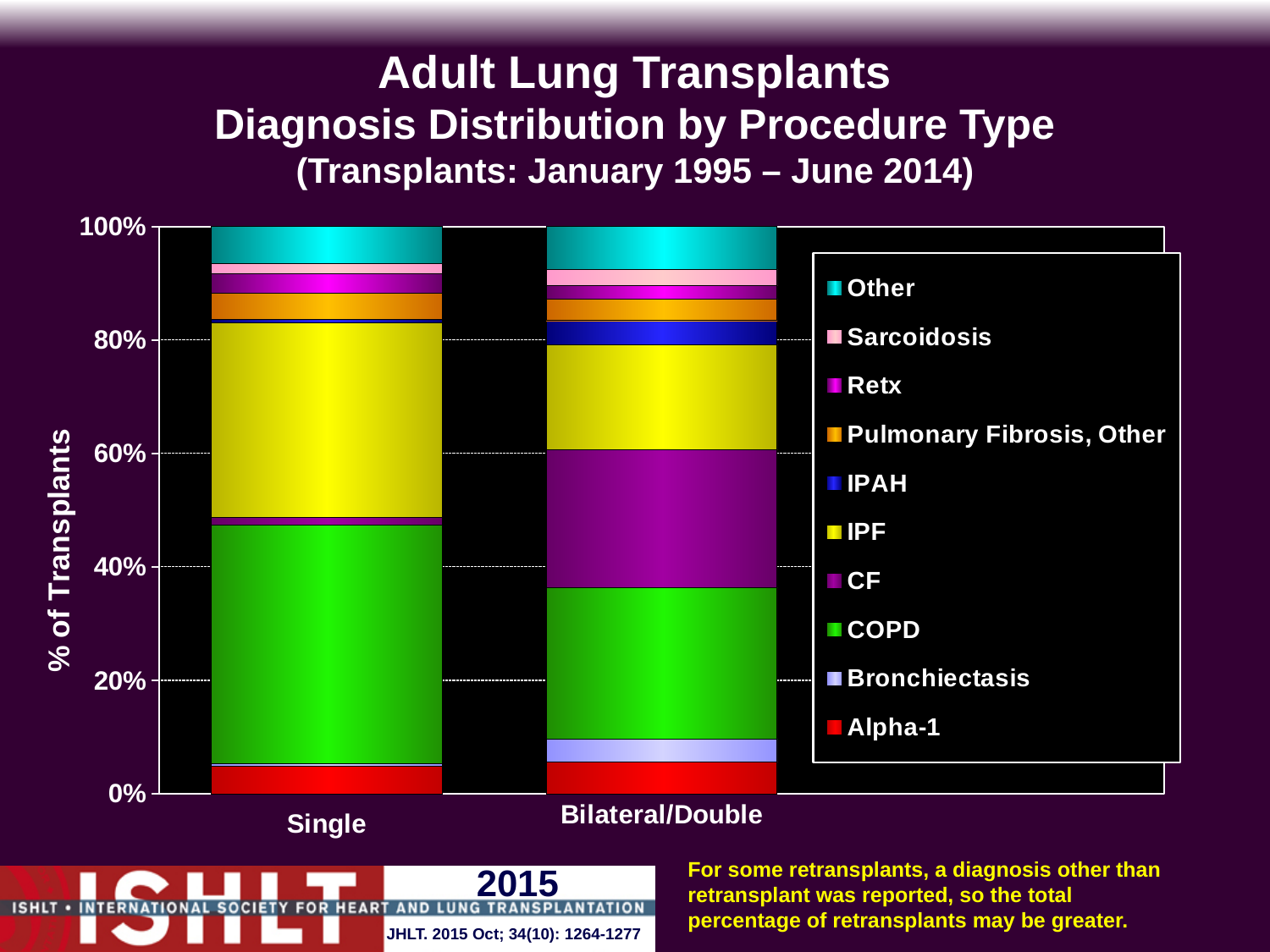
What kind of chart is shown on the slide? Stacked bar chart What is the label of the y axis? % of Transplants What is the total height of the Single stacked bar? 100% Which category has the larger COPD segment, Single or Bilateral/Double? Single Which diagnosis is the largest segment of the Single bar? COPD How many diagnosis series does the legend list? 10 Is the CF share of the Bilateral/Double bar greater or less than 20%? greater Which category has the larger CF segment, Single or Bilateral/Double? Bilateral/Double Is the COPD share of the Single bar greater or less than 40%? greater Is the Alpha-1 share of the Single bar greater or less than 20%? less How many procedure-type categories are plotted on the x axis? 2 What time period of transplants does the chart title cover? January 1995 – June 2014